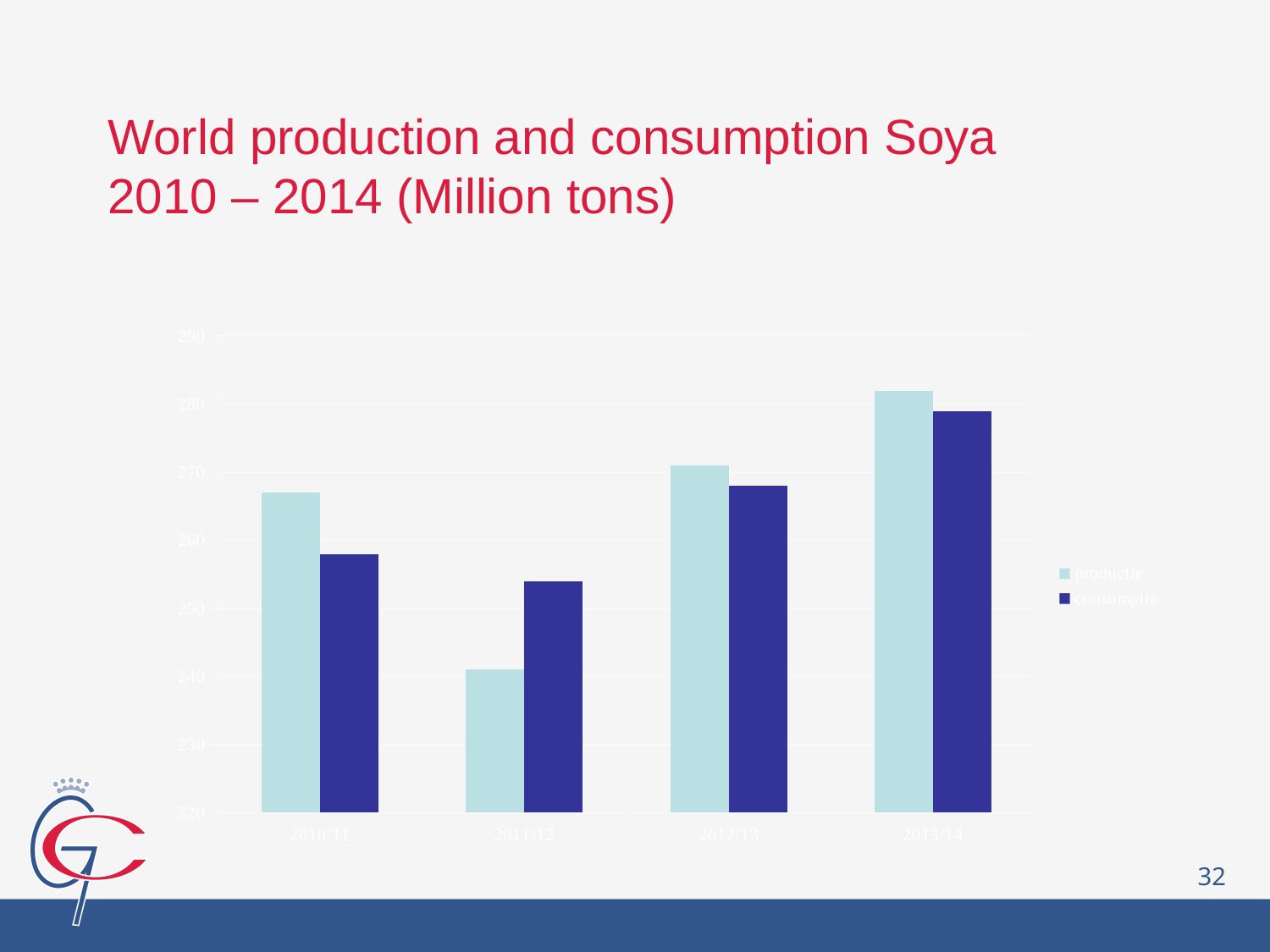
How many year categories are shown on the x axis? 4 From 2011/12 to 2013/14, does the productie value rise or fall? rise Which series are listed in the legend? productie and consumptie In 2011/12, which is larger, productie or consumptie? consumptie Is the consumptie value for 2013/14 greater or less than 270? greater In which year is the productie value highest? 2013/14 In which year is the productie value lowest? 2011/12 What kind of chart is shown on the slide? bar chart In 2010/11, which is larger, productie or consumptie? productie How many series does the legend list? 2 Is the productie value for 2011/12 greater or less than 250? less In which year is the consumptie value highest? 2013/14